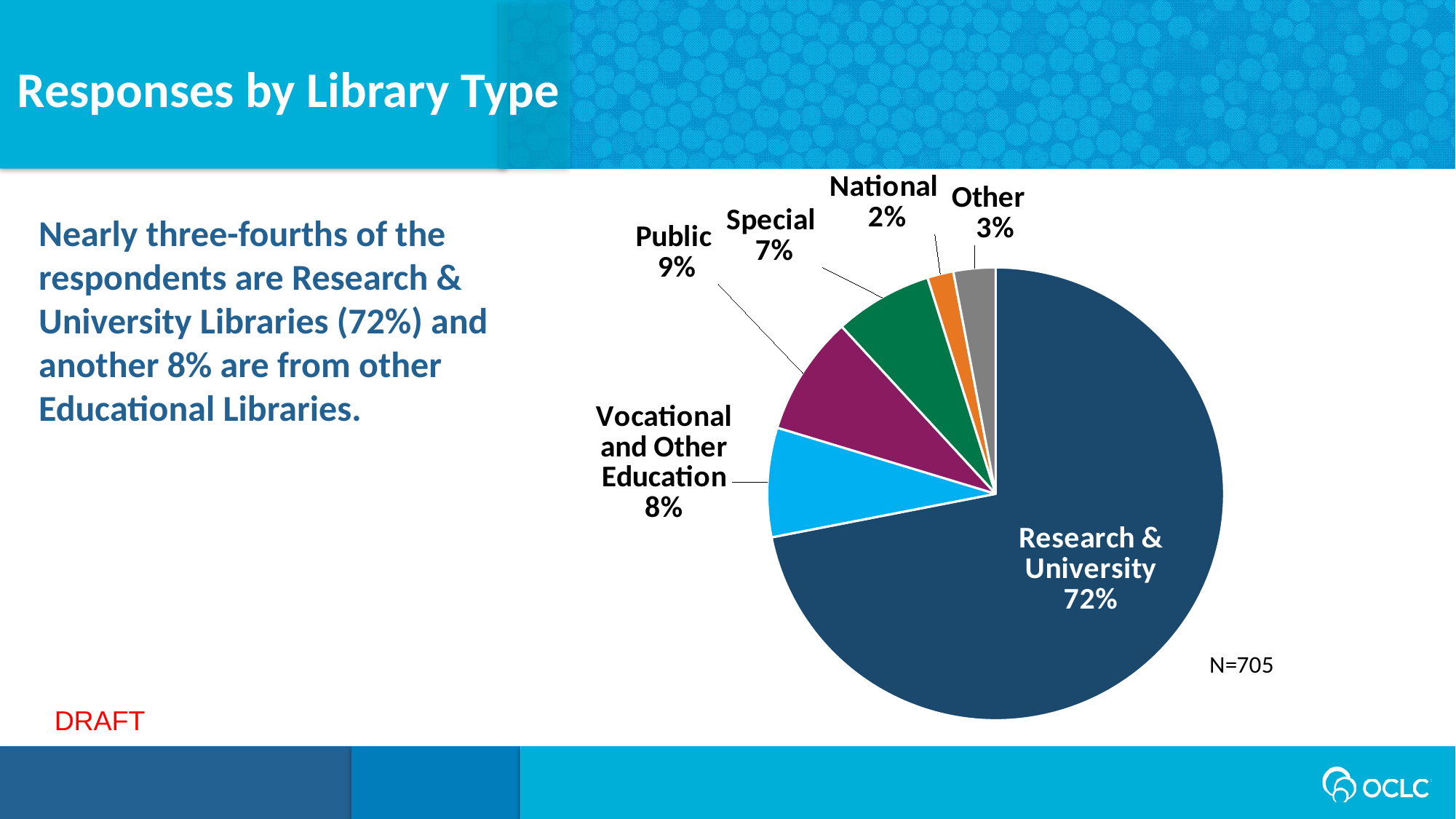
Which library type has the largest share of responses? Research & University Which library type has the smallest share of responses? National What is the total number of respondents (N) shown on the chart? 705 What kind of chart is shown on the slide? pie chart What percentage of respondents are National libraries? 2% What percentage of respondents are Special libraries? 7% How many library types (slices) are shown in the pie chart? 6 What is the difference in percentage points between the Public and Special slices? 2% Which is larger, the Other slice or the National slice? Other What share of respondents are Research & University libraries? 72% What percentage of respondents are Public libraries? 9% What percentage of respondents are Vocational and Other Education libraries? 8%